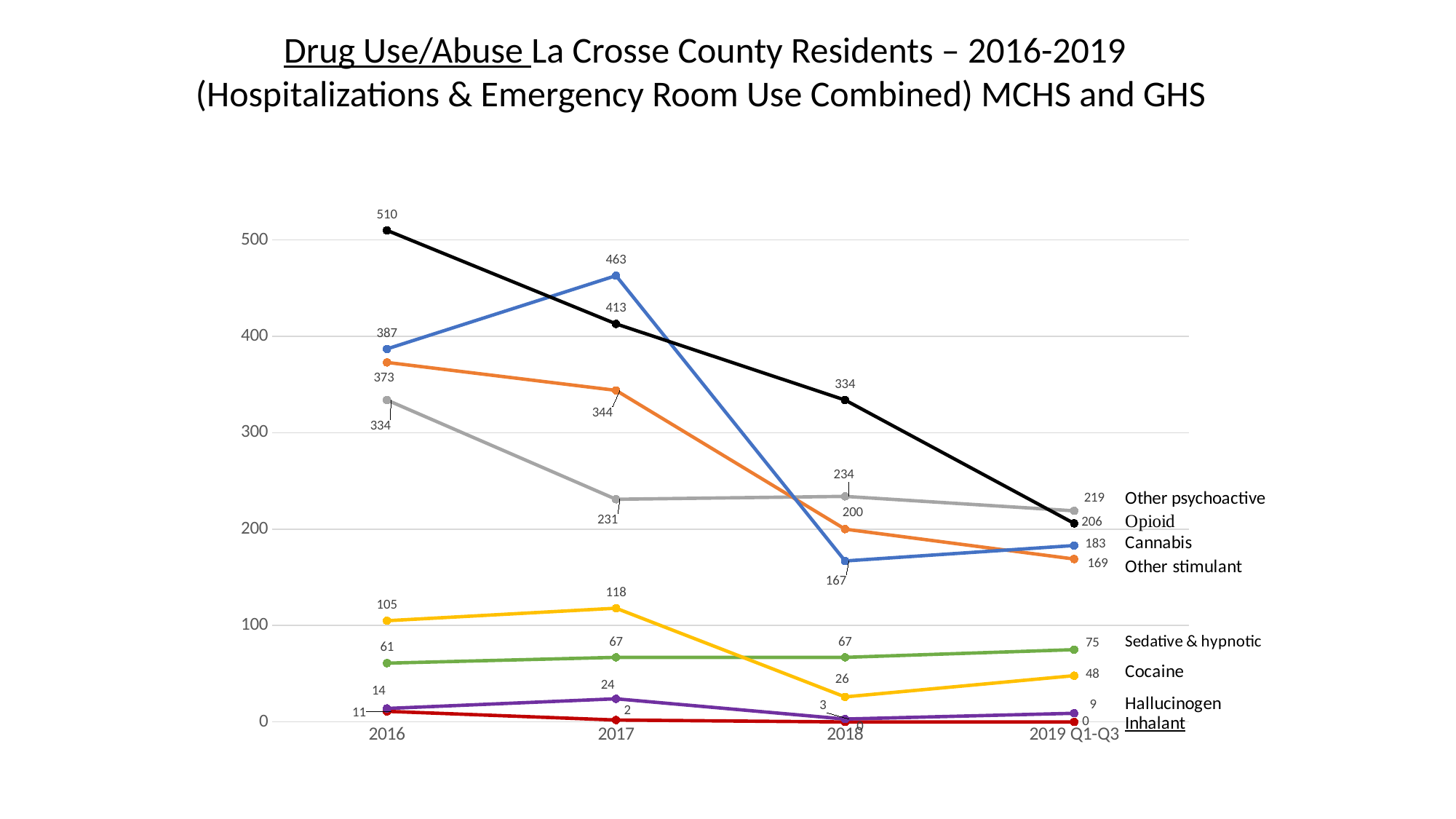
Does the Opioid series rise or fall from 2016 to 2019 Q1-Q3? Falls How many time periods are plotted on the x axis? 4 Which series has the highest value in 2016? Opioid Which series has the lowest value in 2019 Q1-Q3? Inhalant What is the Opioid value for 2016? 510 What is the Cocaine value for 2018? 26 By how much did the Opioid value fall from 2016 to 2019 Q1-Q3? 304 In 2019 Q1-Q3, which is larger: Cannabis or Other stimulant? Cannabis What is the Cannabis value for 2017? 463 How many series are labeled on the chart? 8 What is the Sedative & hypnotic value for 2019 Q1-Q3? 75 What kind of chart is shown on the slide? Line chart